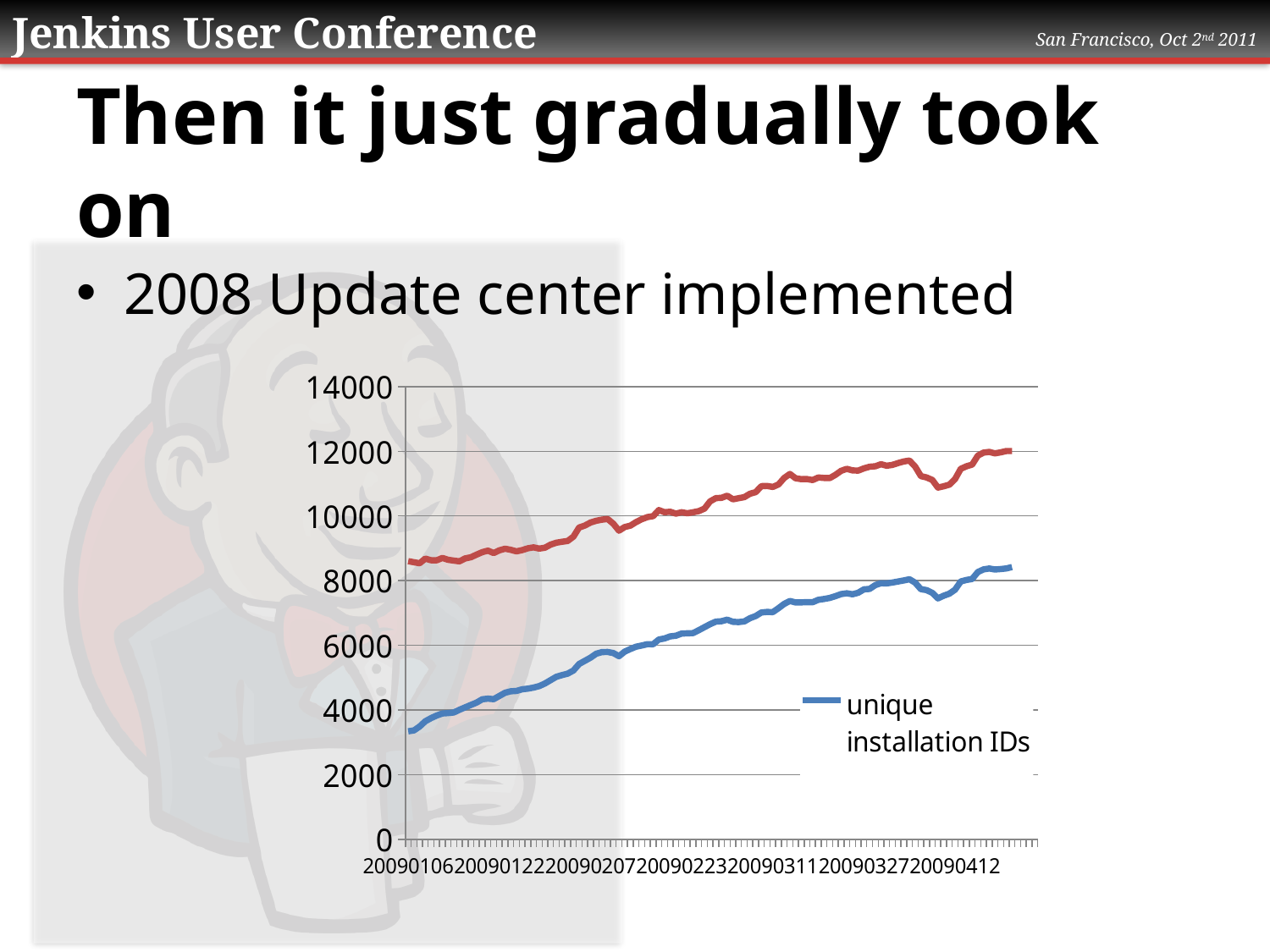
Is the value of the 'unique installation IDs' line at 20090223 greater or less than 6000? greater Is the value of the red line at 20090106 greater or less than 8000? greater What kind of chart is shown on the slide? line chart What series name is shown in the chart legend? unique installation IDs How many lines are plotted on the chart? 2 Does the blue 'unique installation IDs' line rise or fall from left to right along the x axis? rise Is the value of the red line at 20090412 greater or less than 10000? greater Does the red line rise or fall overall from left to right along the x axis? rise Which line is higher throughout the chart, the red line or the blue line? the red line What is the highest value shown on the y axis of the chart? 14000